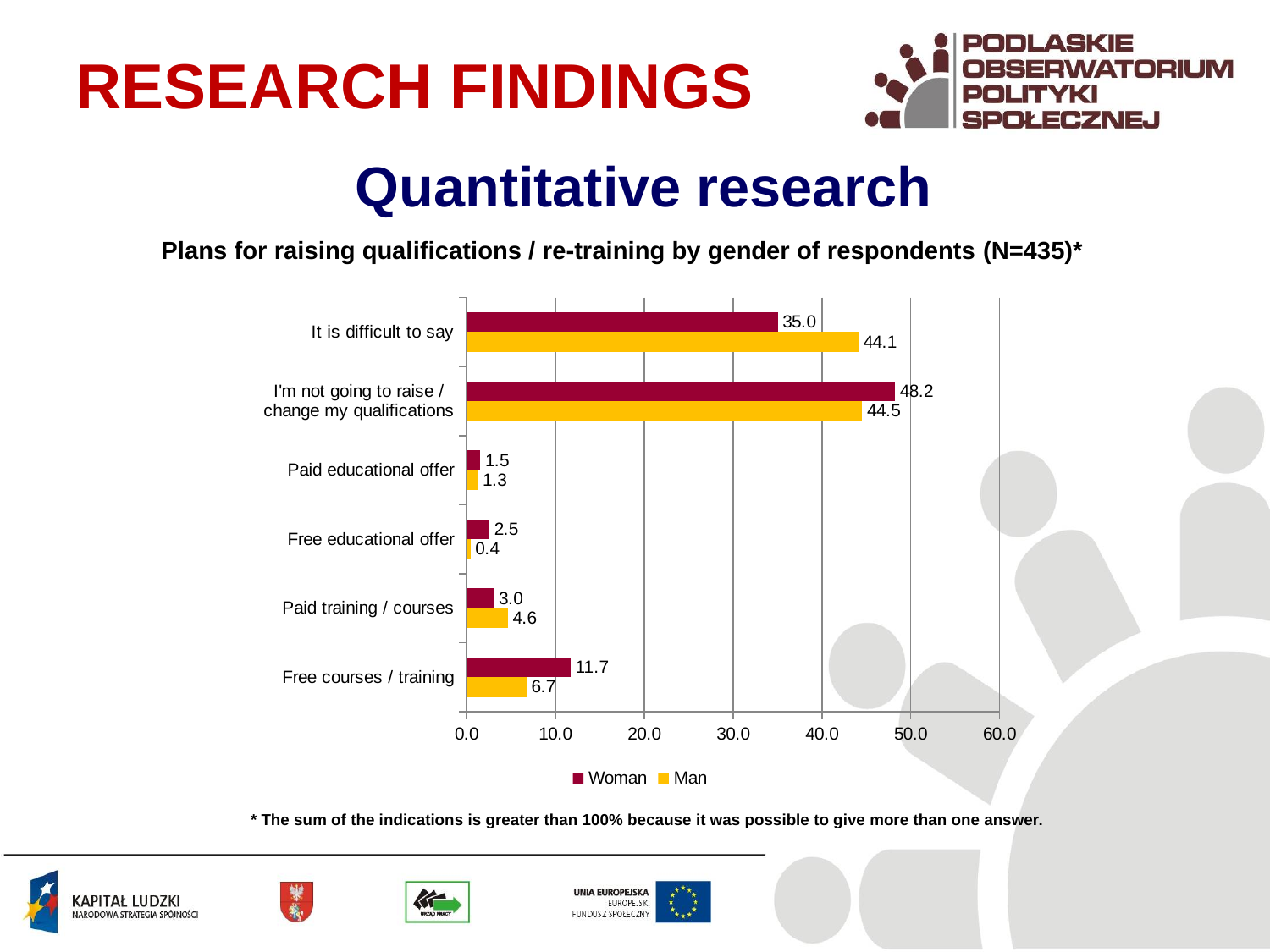
What is the value for Man for "It is difficult to say"? 44.1 What is the value for Woman for "Free courses / training"? 11.7 How many categories are shown on the chart? 6 What is the value for Man for "Free educational offer"? 0.4 Which is larger for "Paid training / courses": the Woman value or the Man value? Man Which category has the highest value for Woman? I'm not going to raise / change my qualifications Is the Woman value for "I'm not going to raise / change my qualifications" greater or less than 40.0? greater How many series does the legend list? 2 What kind of chart is shown on the slide? Bar chart Which colour represents the Man series in the chart? Yellow Which category has the lowest value for Man? Free educational offer What is the difference between the Woman and Man values for "It is difficult to say"? 9.1